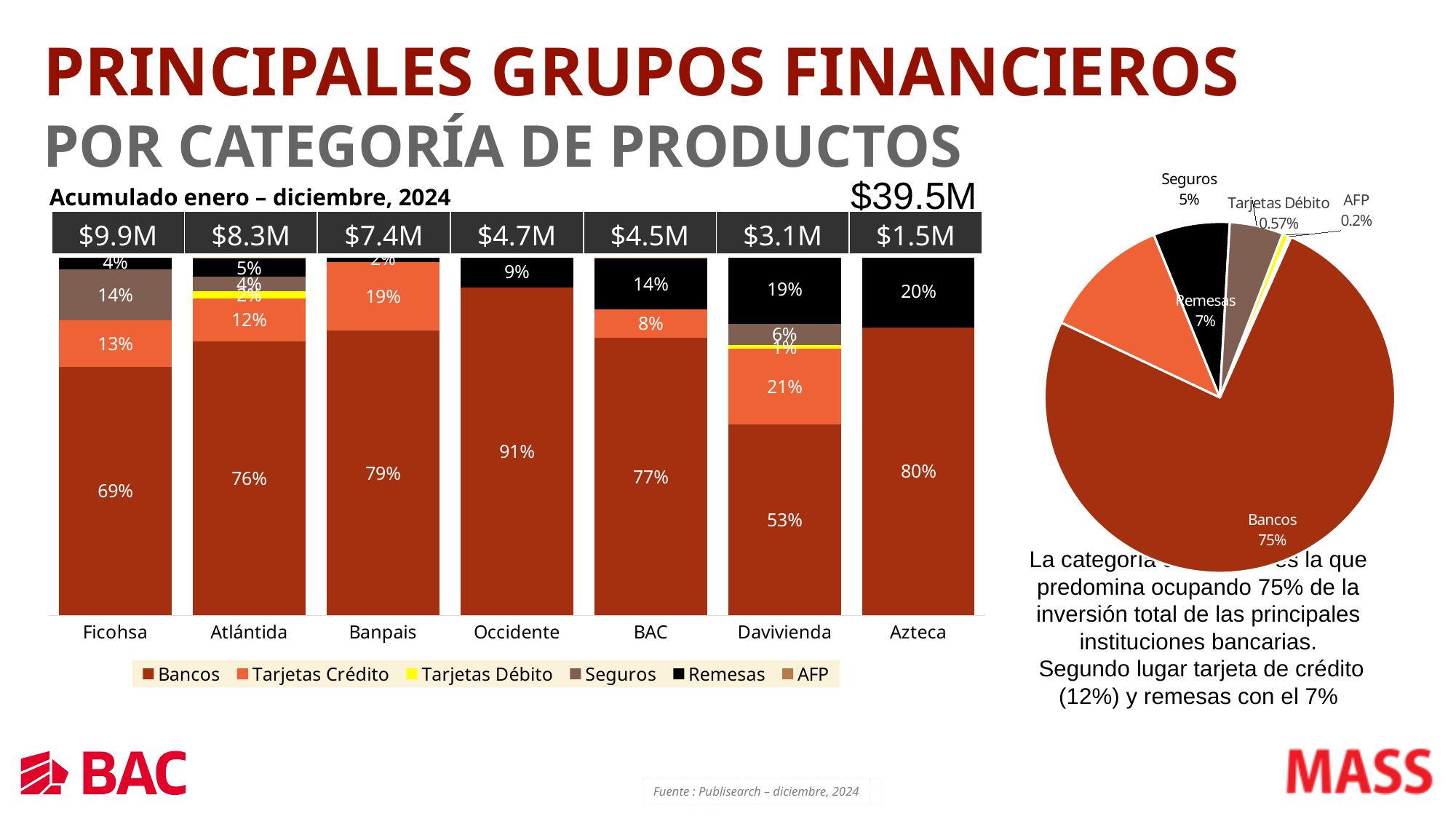
In the stacked bar chart, which financial group has the highest Bancos percentage? Occidente How many product categories does the legend of the stacked bar chart list? 6 In the stacked bar chart, which financial group has the lowest Bancos percentage? Davivienda What type of chart is used on the left side of the slide to show the financial groups by product category? Stacked bar chart In the stacked bar chart, which has a larger Seguros percentage, Ficohsa or Davivienda? Ficohsa In the stacked bar chart, what is the difference in percentage points between Davivienda's Tarjetas Crédito share and BAC's Tarjetas Crédito share? 13 percentage points In the stacked bar chart, what total amount is shown above the Ficohsa bar? $9.9M In the stacked bar chart, what is the Remesas percentage for Azteca? 20% How many financial groups are shown on the x axis of the stacked bar chart? 7 In the pie chart, which category has the largest slice? Bancos In the pie chart, what share does Remesas have? 7% In the stacked bar chart, what percentage of Occidente's investment goes to Bancos? 91%